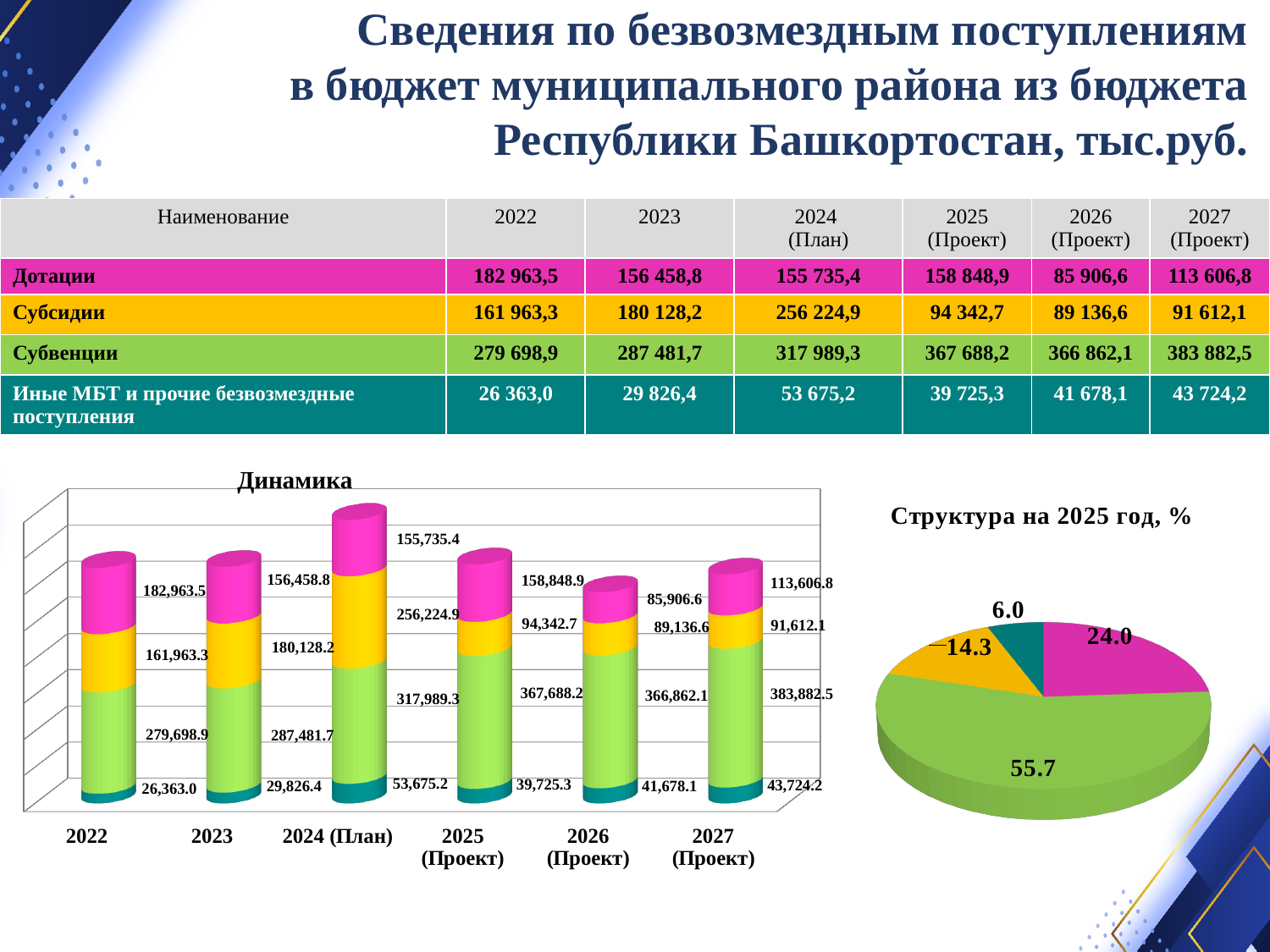
In the "Динамика" chart, what is the value of the bottom (dark teal) segment of the 2022 bar? 26,363.0 In the "Структура на 2025 год, %" pie chart, what is the value of the largest slice? 55.7 In the "Динамика" chart, what is the difference between the green segment values for 2027 (Проект) and 2022? 104,183.6 In the "Динамика" chart, what is the total of the stacked bar for 2025 (Проект)? 660,605.1 How many categories are shown on the x axis of the "Динамика" chart? 6 In the "Динамика" chart, which is larger: the pink segment for 2022 or the pink segment for 2023? 2022 In the "Динамика" chart, what is the value of the top (pink) segment of the 2024 (План) bar? 155,735.4 What kind of chart is the "Структура на 2025 год, %" chart on the right? pie chart In the "Структура на 2025 год, %" pie chart, what is the value of the smallest slice? 6.0 In the "Динамика" chart, which category has the shortest stacked bar? 2026 (Проект) What kind of chart is the "Динамика" chart on the left? bar chart In the "Динамика" chart, which category has the tallest stacked bar? 2024 (План)